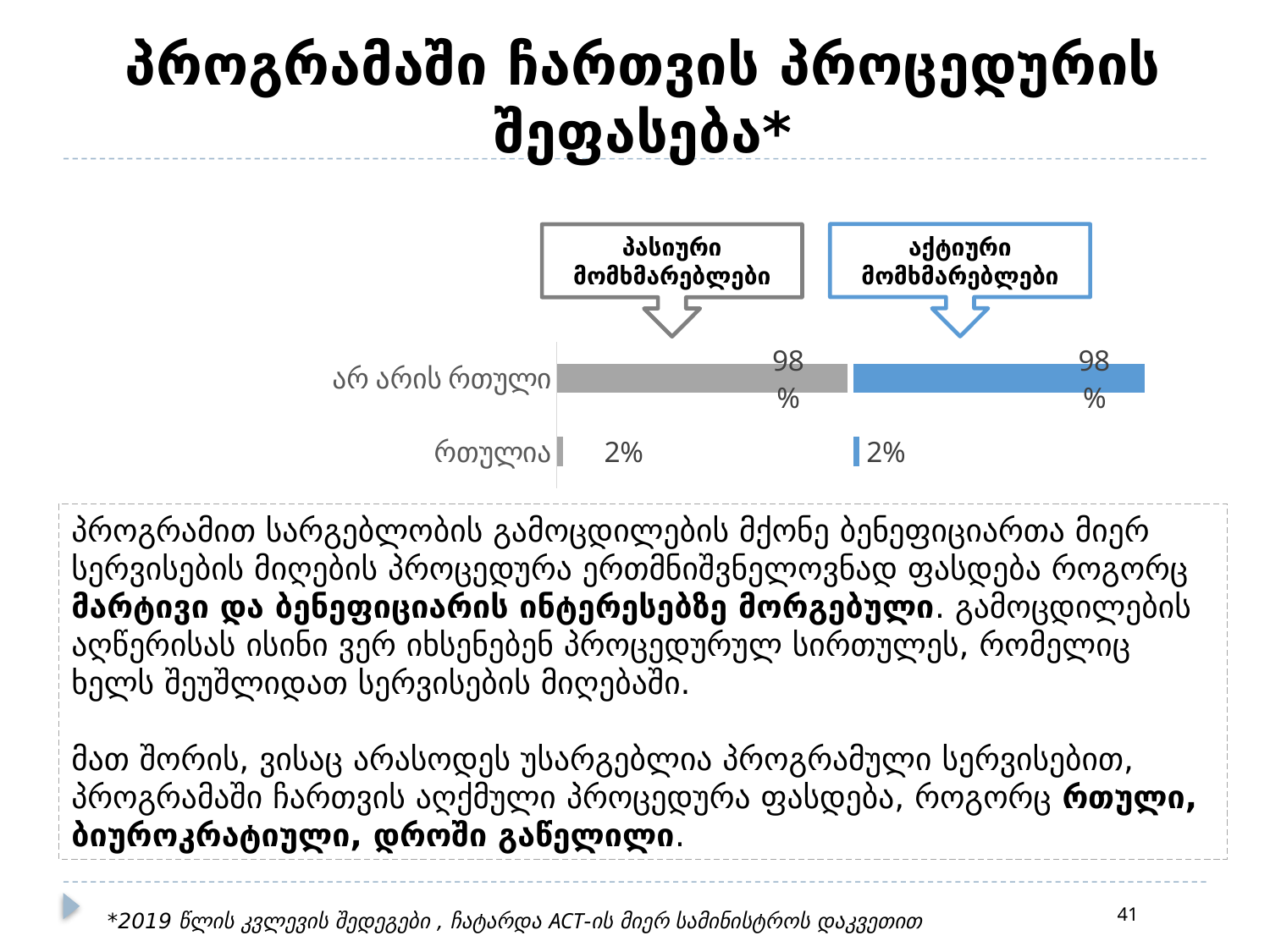
What is the value for "არ არის რთული" for აქტიური მომხმარებლები? 98% What is the difference between "არ არის რთული" and "რთულია" for პასიური მომხმარებლები? 96% What kind of chart is shown on the slide? bar chart Which category has the lowest value for აქტიური მომხმარებლები? რთულია How many series does the chart show? 2 How many categories are shown on the chart? 2 What is the value for "რთულია" for აქტიური მომხმარებლები? 2% What is the value for "არ არის რთული" for პასიური მომხმარებლები? 98% Which is larger for აქტიური მომხმარებლები: "არ არის რთული" or "რთულია"? არ არის რთული Which category has the highest value for პასიური მომხმარებლები? არ არის რთული Which colour represents აქტიური მომხმარებლები on the chart? blue What is the value for "რთულია" for პასიური მომხმარებლები? 2%